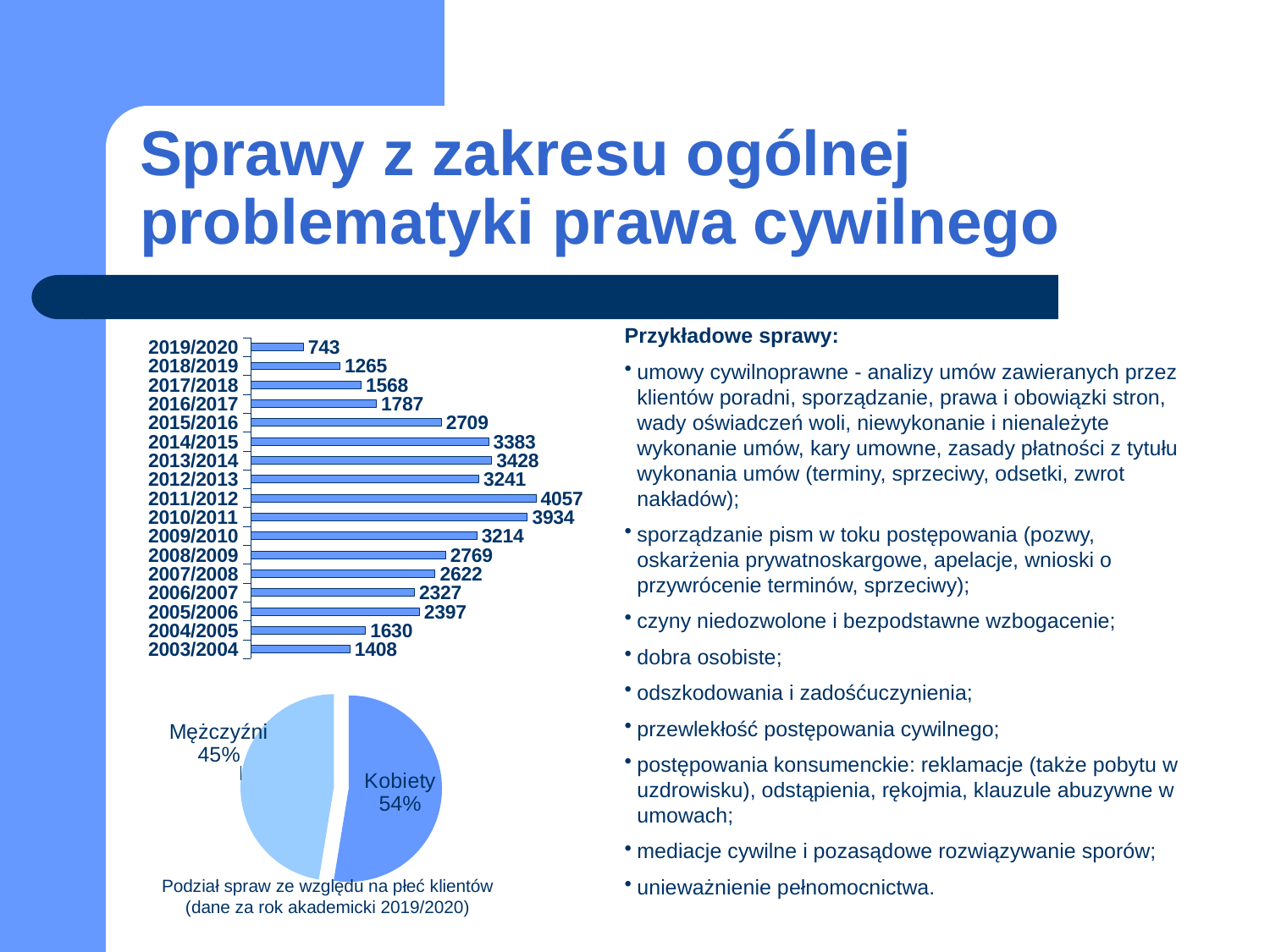
What kind of chart is shown at the top left of the slide? bar chart In the bar chart at the top left of the slide, what is the value for 2003/2004? 1408 In the bar chart at the top left of the slide, what is the value for 2011/2012? 4057 In the pie chart at the bottom left of the slide, what share is labelled Mężczyźni? 45% In the bar chart at the top left of the slide, what is the difference between the values for 2011/2012 and 2010/2011? 123 In the bar chart at the top left of the slide, which is larger, the value for 2013/2014 or the value for 2014/2015? 2013/2014 How many years are shown in the bar chart at the top left of the slide? 17 In the pie chart at the bottom left of the slide, what share is labelled Kobiety? 54% In the bar chart at the top left of the slide, which year has the highest value? 2011/2012 In the bar chart at the top left of the slide, which year has the lowest value? 2019/2020 In the bar chart at the top left of the slide, what is the value for 2019/2020? 743 What is the caption of the pie chart at the bottom left of the slide? Podział spraw ze względu na płeć klientów (dane za rok akademicki 2019/2020)